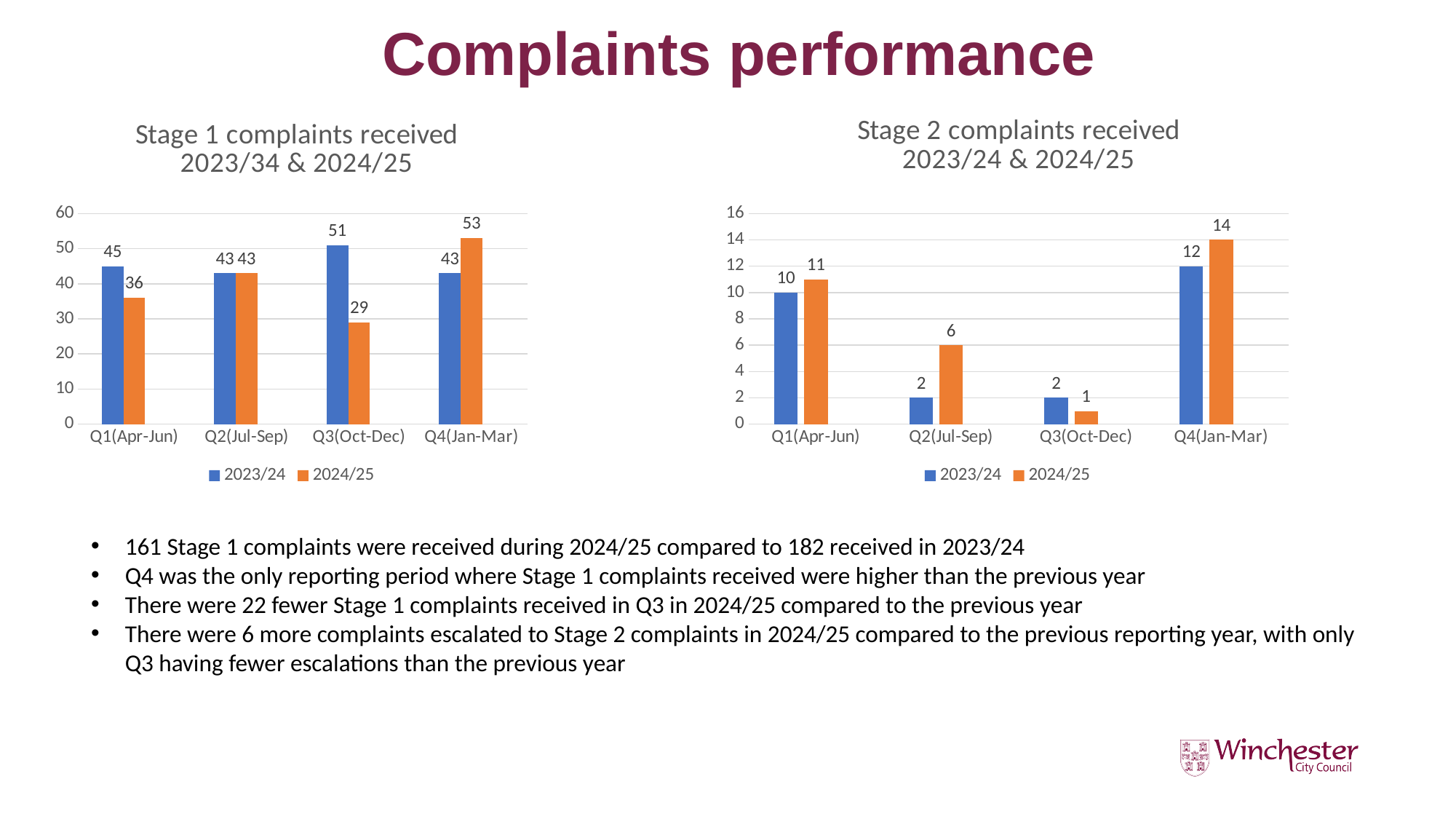
What type of chart is the Stage 2 complaints received chart? Bar chart In the Stage 2 complaints received chart, what is the value for 2024/25 in Q2(Jul-Sep)? 6 In the Stage 1 complaints received chart, which quarter has the highest 2024/25 value? Q4(Jan-Mar) In the Stage 1 complaints received chart, what is the value for 2023/24 in Q1(Apr-Jun)? 45 How many series does the legend of the Stage 1 complaints received chart list? 2 In the Stage 2 complaints received chart, which quarter has the lowest 2024/25 value? Q3(Oct-Dec) In the Stage 1 complaints received chart, which colour represents the 2024/25 series? Orange In the Stage 1 complaints received chart, what is the difference between the 2023/24 and 2024/25 values in Q3(Oct-Dec)? 22 In the Stage 2 complaints received chart, what is the difference between the 2024/25 and 2023/24 values in Q4(Jan-Mar)? 2 In the Stage 1 complaints received chart, which is larger in Q4(Jan-Mar): 2023/24 or 2024/25? 2024/25 In the Stage 1 complaints received chart, what is the value for 2024/25 in Q3(Oct-Dec)? 29 How many quarters are shown on the x axis of the Stage 2 complaints received chart? 4